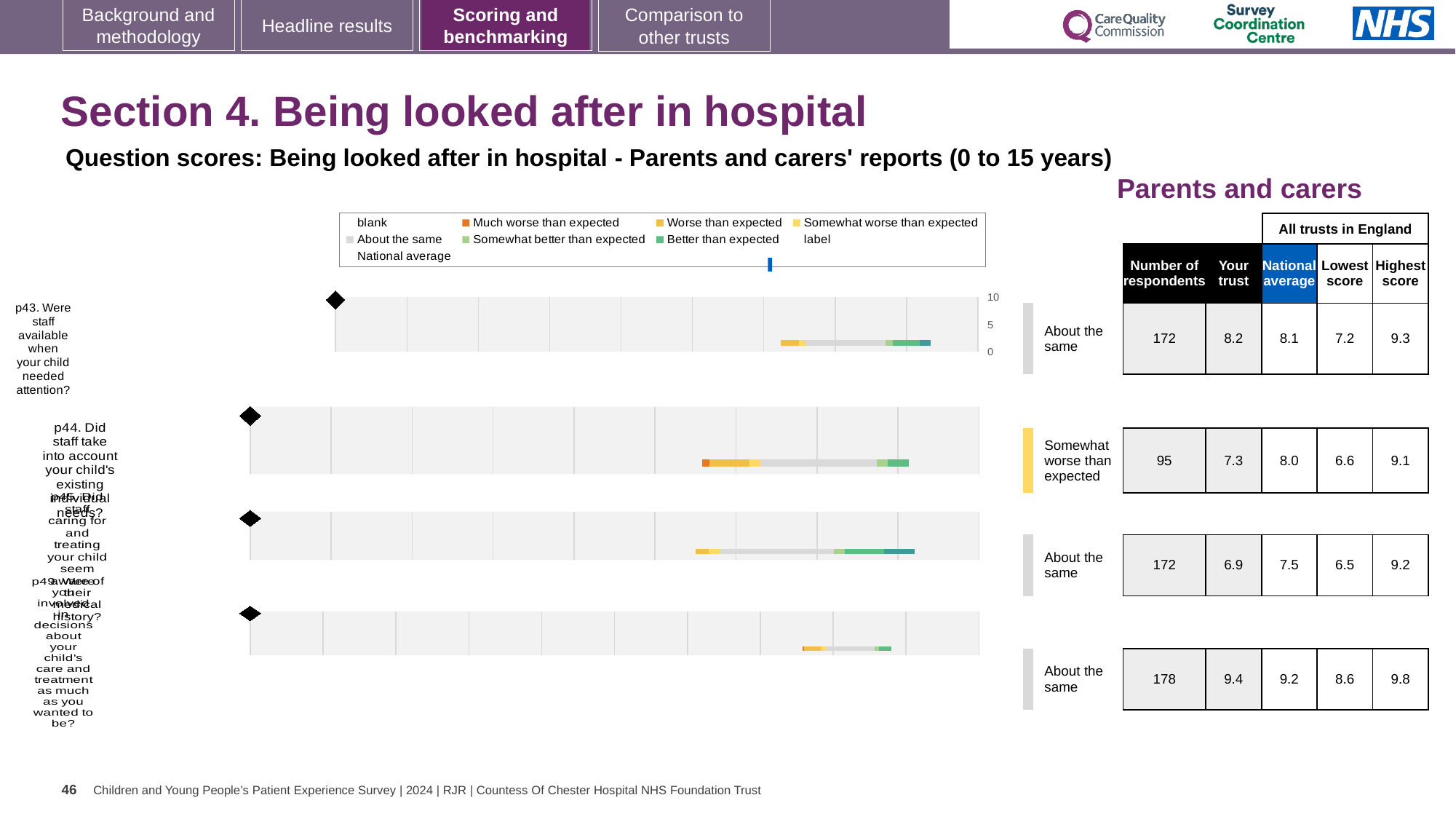
For the top chart (p43, Were staff available when your child needed attention?), what is the 'Your trust' score in the table? 8.2 For the top chart (p43), is the 'Your trust' score or the national average higher? Your trust How many question charts (rows) are shown on the slide? 4 Which chart row has the highest 'Your trust' score? the bottom chart (9.4) For the second chart from the top, what is the benchmark category shown next to the bar? Somewhat worse than expected For the bottom chart, what is the difference between the highest score and the lowest score among all trusts in England? 1.2 What kind of chart is used to show the question scores on this slide? bar chart For the top chart (p43), what is the national average score? 8.1 In the legend, which colour represents 'Much worse than expected'? orange For the second chart from the top, what is the 'Your trust' score? 7.3 For the third chart from the top, what is the lowest score among all trusts in England? 6.5 For the top chart (p43), how many respondents are listed? 172